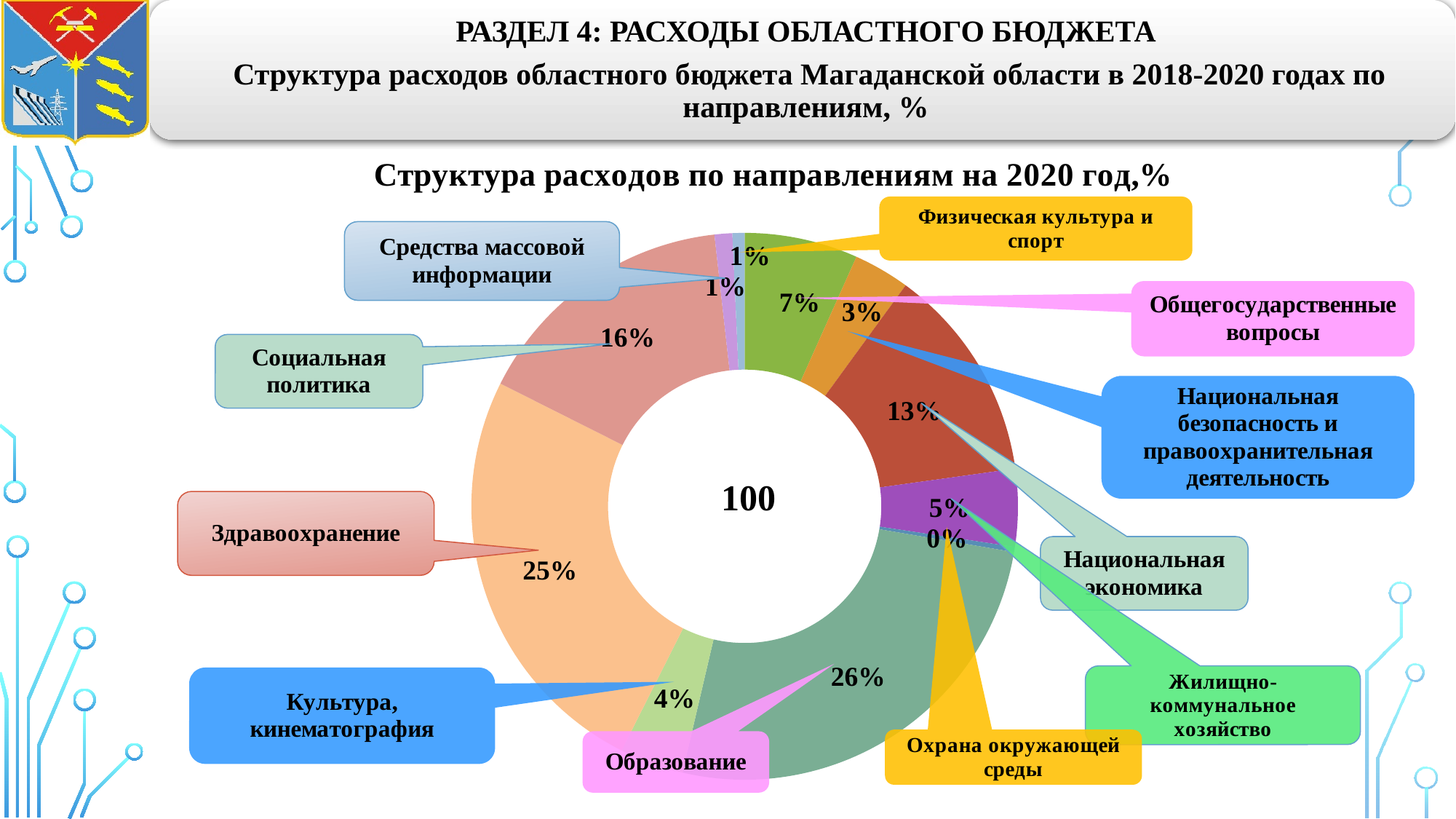
What share of expenditures goes to Жилищно-коммунальное хозяйство? 5% Which has a larger share: Социальная политика or Национальная экономика? Социальная политика What kind of chart is shown on the slide? Pie (doughnut) chart What share of expenditures goes to Социальная политика? 16% Which direction has the largest share of expenditures? Образование What share of expenditures goes to Здравоохранение? 25% What is the difference between the shares of Образование and Здравоохранение? 1% What share of expenditures goes to Национальная экономика? 13% What number is printed in the centre of the doughnut chart? 100 What share of expenditures goes to Образование in 2020? 26% What share of expenditures goes to Культура, кинематография? 4% What share of expenditures goes to Охрана окружающей среды? 0%